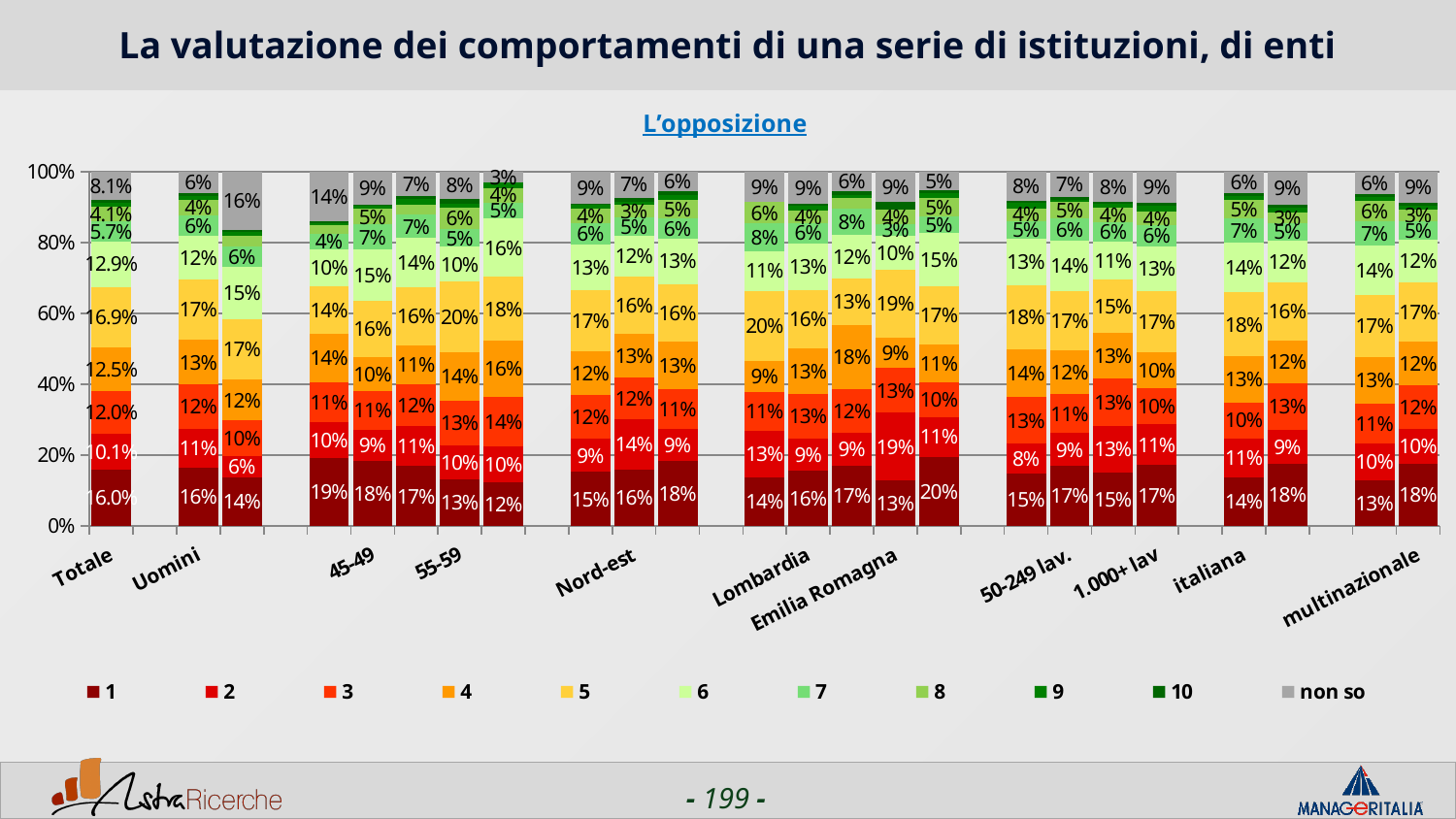
What is the value of series 1 for the Totale bar? 16.0% What is the value of series 2 for Emilia Romagna? 19% What is the value of series 1 for Nord-est? 16% What is the value of series 1 for multinazionale? 18% What is the last entry in the legend? non so What is the value of 'non so' for the Totale bar? 8.1% What kind of chart is shown on the slide? Stacked bar chart What is the value of series 5 for the Totale bar? 16.9% In the Totale bar, what is the difference between series 5 and series 4? 4.4 percentage points How many series does the legend list? 11 In the Totale bar, which is larger: series 1 or series 2? Series 1 What is the value of series 1 for Uomini? 16%